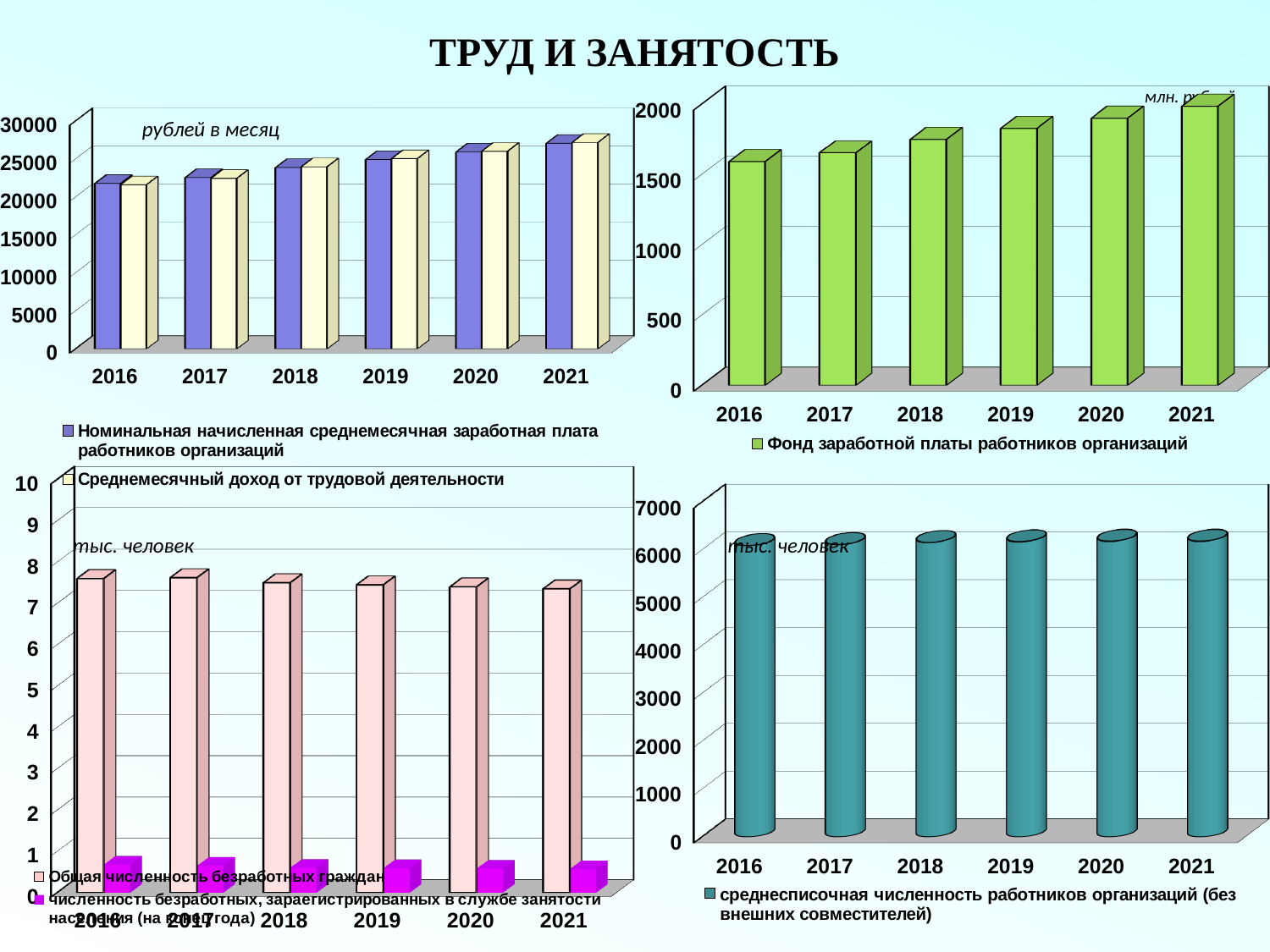
In the top-right chart (Фонд заработной платы работников организаций), how many years are shown on the x axis? 6 In the top-right chart (Фонд заработной платы работников организаций), which year has the lowest value? 2016 In the bottom-left chart (тыс. человек, unemployment), which series is larger in 2021: Общая численность безработных граждан or численность безработных, зарегистрированных в службе занятости населения? Общая численность безработных граждан In the top-left chart (рублей в месяц), is the nominal average monthly wage for 2016 greater or less than 25000? less What kind of chart is the bottom-right chart (среднесписочная численность работников организаций)? bar chart In the bottom-left chart (тыс. человек, unemployment), is the value for Общая численность безработных граждан in 2016 greater or less than 7? greater In the top-left chart (рублей в месяц), how many series does the legend list? 2 In the top-left chart (рублей в месяц), do the wage values rise or fall from 2016 to 2021? rise In the top-left chart (рублей в месяц), which year has the highest nominal average monthly wage (Номинальная начисленная среднемесячная заработная плата)? 2021 In the top-right chart (Фонд заработной платы работников организаций), is the value for 2016 greater or less than 1500? greater